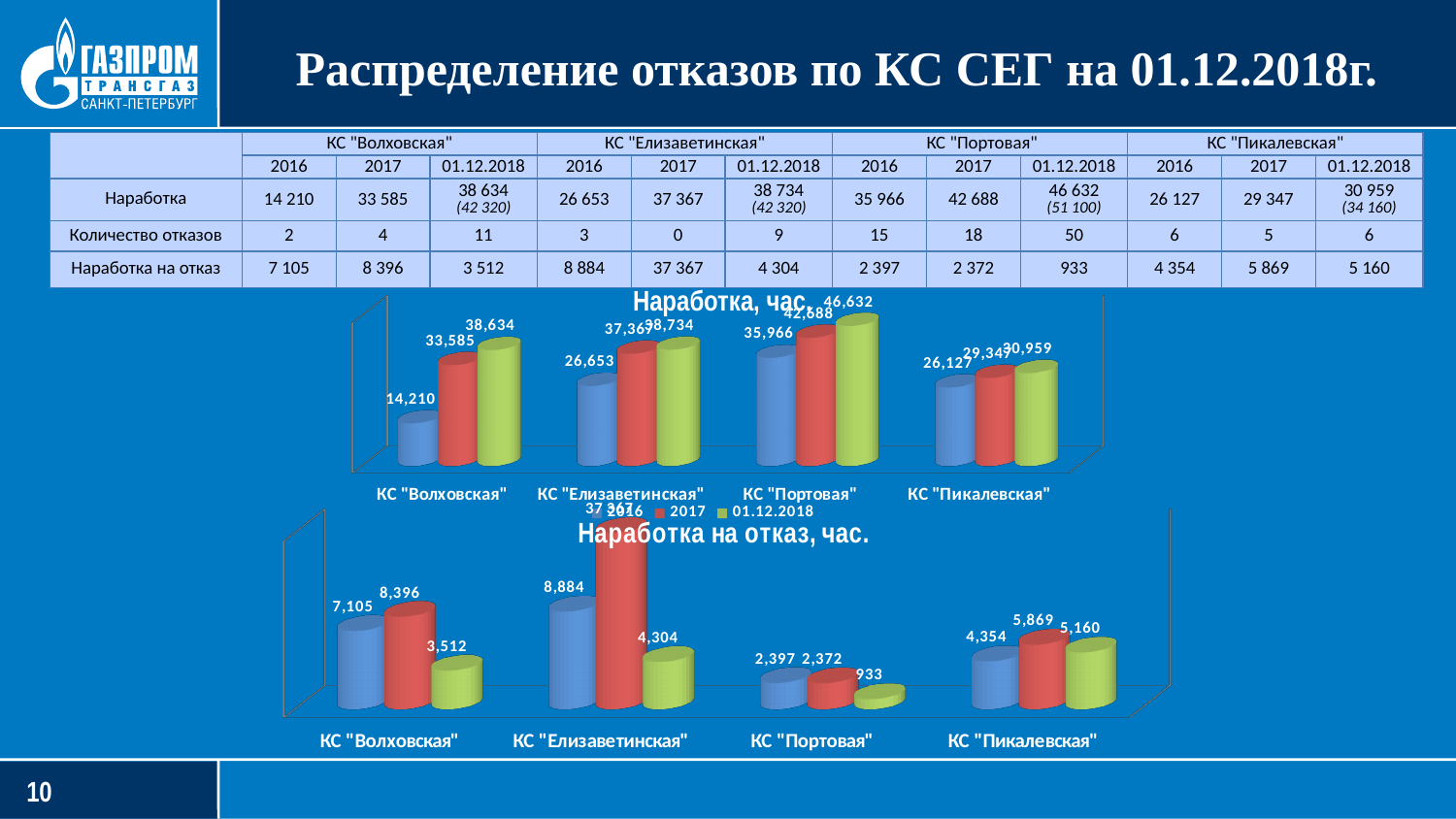
What type of chart is the top chart titled "Наработка, час"? bar chart How many series does the legend of the top chart "Наработка, час" list? 3 How many stations (categories) are shown on the x axis of the bottom chart "Наработка на отказ, час"? 4 In the top chart "Наработка, час", what is the value for КС "Портовая" for 01.12.2018? 46,632 In the top chart "Наработка, час", which station has the lowest value for 2016? КС "Волховская" In the bottom chart "Наработка на отказ, час", which station has the lowest value for 01.12.2018? КС "Портовая" In the bottom chart "Наработка на отказ, час", what is the value for КС "Портовая" for 01.12.2018? 933 In the bottom chart "Наработка на отказ, час", which is larger for КС "Пикалевская": the 2017 value or the 01.12.2018 value? 2017 In the top chart "Наработка, час", which station has the highest value for 01.12.2018? КС "Портовая" In the top chart "Наработка, час", what is the value for КС "Волховская" for 2016? 14,210 In the top chart "Наработка, час", do the values for КС "Пикалевская" rise or fall from 2016 to 01.12.2018? rise In the top chart "Наработка, час", what is the difference between the 2017 and 2016 values for КС "Волховская"? 19,375